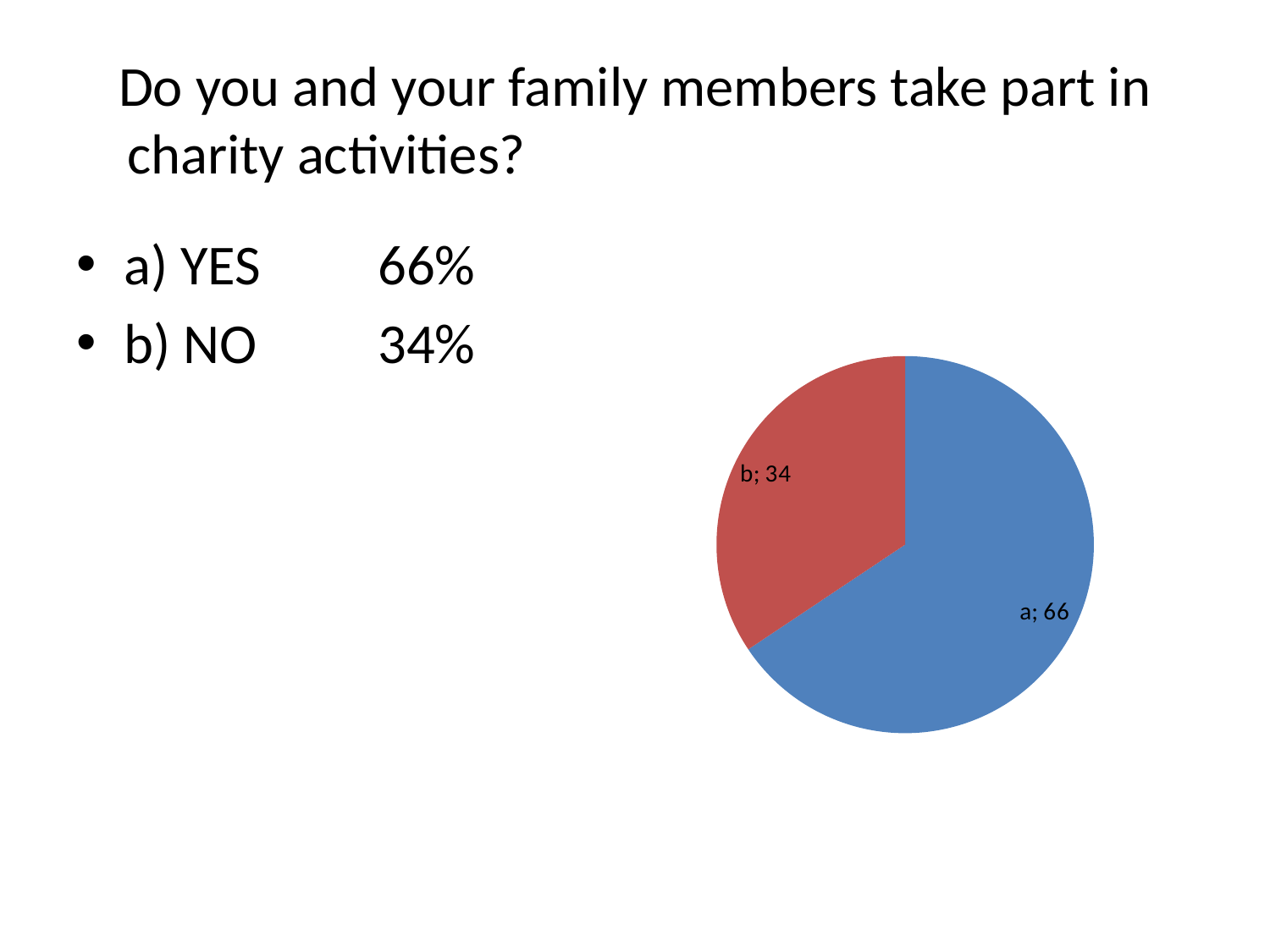
What kind of chart is shown on the slide? pie chart How many slices does the pie chart have? 2 What is the value shown for slice b in the pie chart? 34 What is the total of the two slice values in the pie chart? 100 Which slice of the pie chart is the largest? a What is the difference between the values for slice a and slice b? 32 What colour is slice a in the pie chart? blue What is the value shown for slice a in the pie chart? 66 What share of the pie does slice a represent? 66% What colour is slice b in the pie chart? red Which is larger, the value for slice a or slice b? a Which slice of the pie chart is the smallest? b